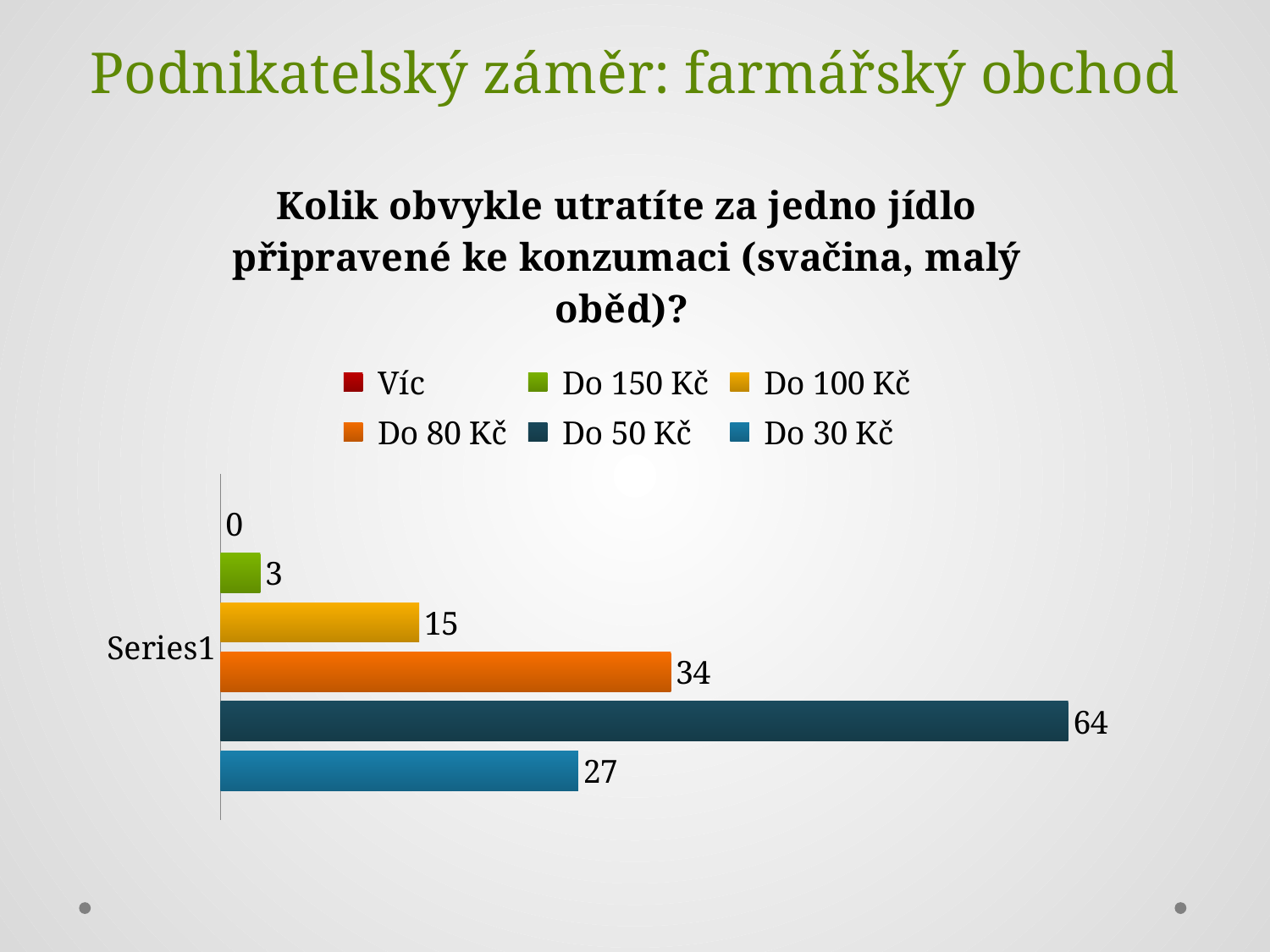
Which series has the highest value? Do 50 Kč What is the value for Do 30 Kč? 27 Which series has the lowest value? Víc Which is larger, the value for Do 30 Kč or the value for Do 100 Kč? Do 30 Kč What is the total of the values for Do 150 Kč and Do 100 Kč? 18 What is the value for Víc? 0 How many series does the legend list? 6 What is the value for Do 50 Kč? 64 What kind of chart is shown on the slide? Bar chart What is the difference between the values for Do 50 Kč and Do 80 Kč? 30 What colour is the bar for Do 80 Kč? Orange What is the value for Do 100 Kč? 15